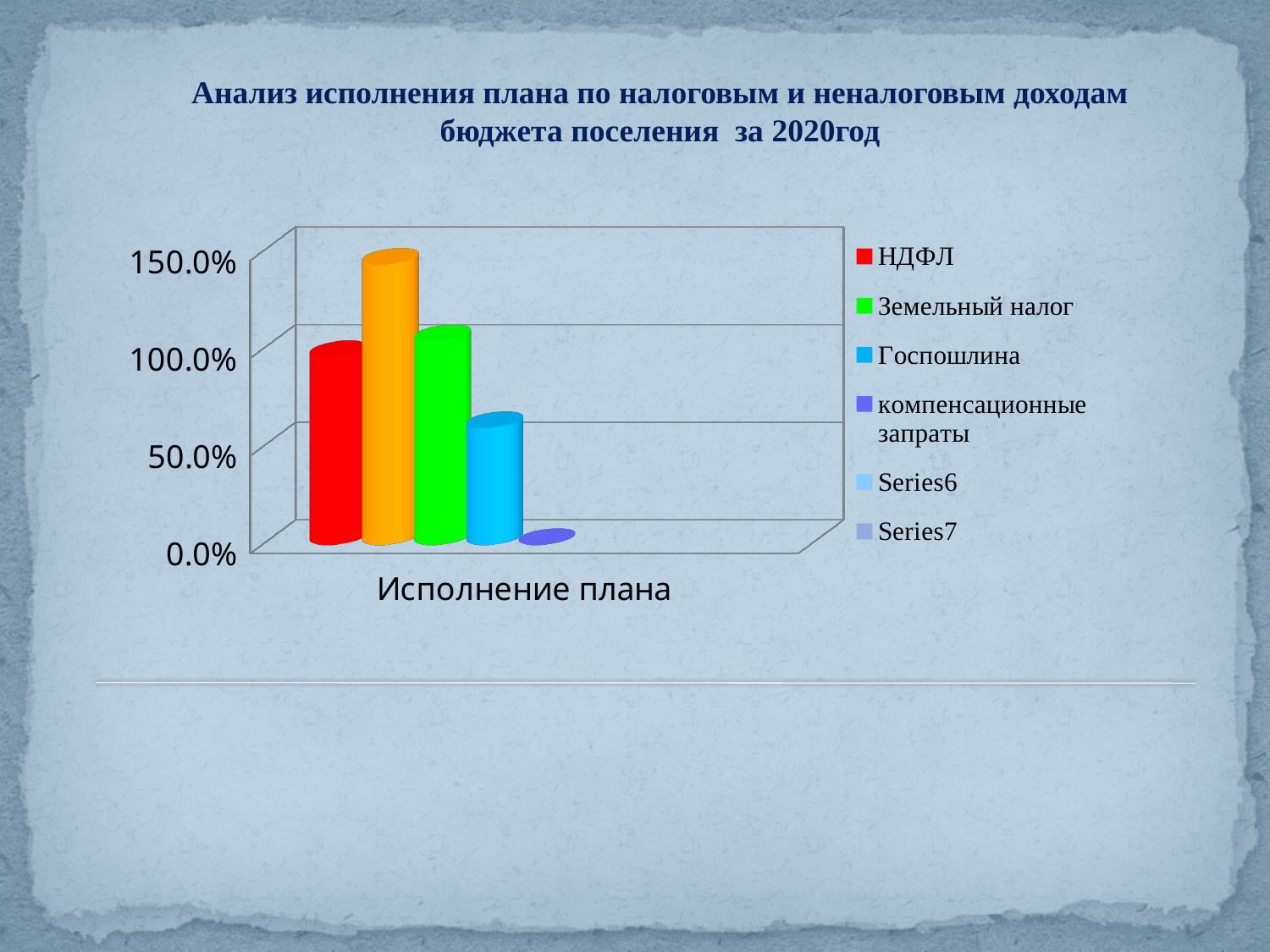
What is the category label on the x axis? Исполнение плана What kind of chart is shown on the slide? bar chart What colour is the bar for НДФЛ? red Which is larger, the value for Земельный налог or the value for Госпошлина? Земельный налог Is the value for Госпошлина greater or less than 100.0%? less Is the value for Госпошлина greater or less than 50.0%? greater How many series does the legend list? 6 Which is larger, the value for НДФЛ or the value for Госпошлина? НДФЛ Is the value for Земельный налог greater or less than 100.0%? greater How many categories are shown on the x axis? 1 Which series has the lowest value? компенсационные запраты